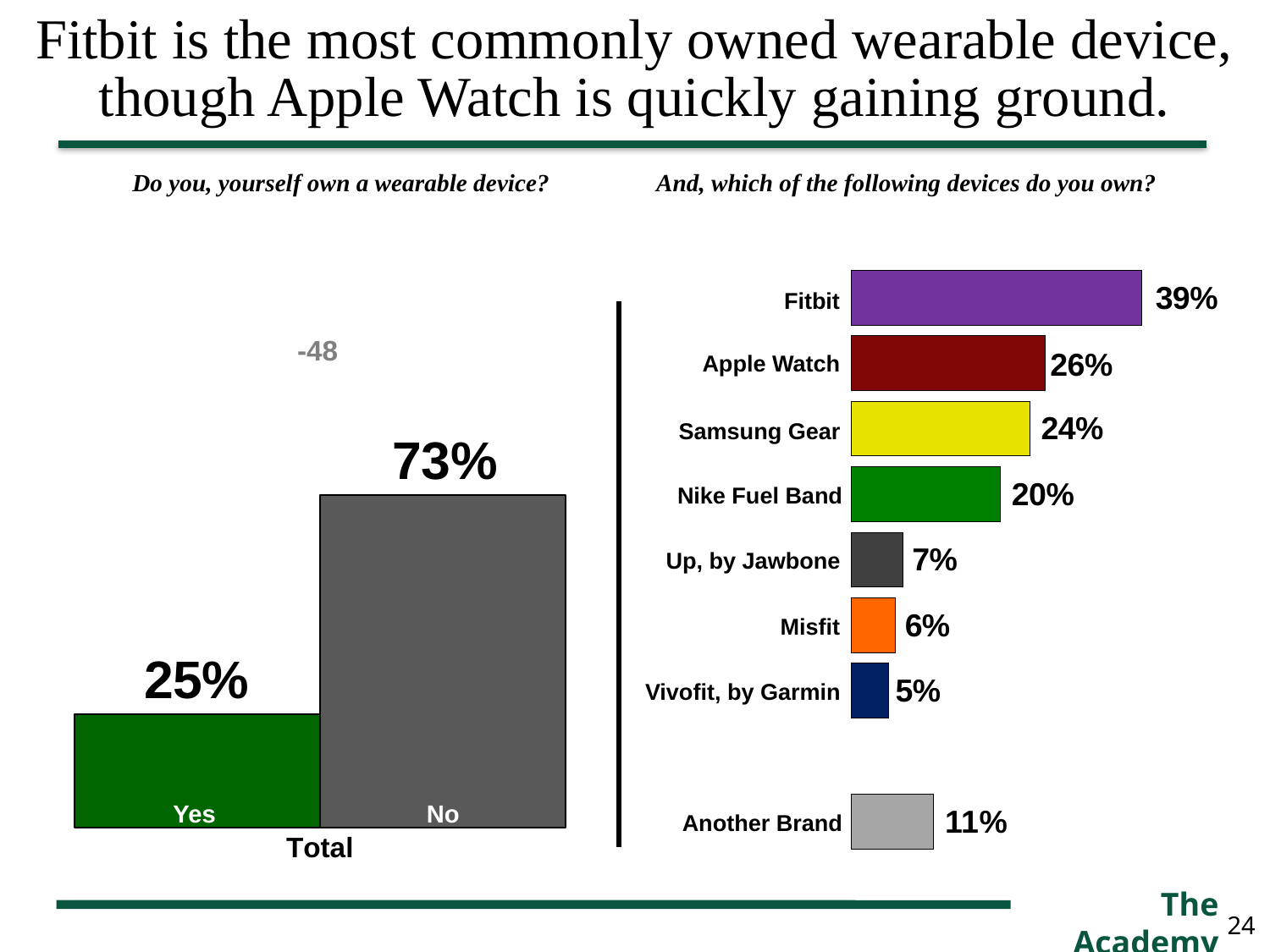
What type of chart is the right chart ('And, which of the following devices do you own?')? Bar chart How many device categories are shown in the right chart ('And, which of the following devices do you own?')? 8 In the left chart ('Do you, yourself own a wearable device?'), what percentage answered Yes? 25% In the right chart ('And, which of the following devices do you own?'), which device has the highest ownership? Fitbit In the right chart ('And, which of the following devices do you own?'), what percentage own a Samsung Gear? 24% In the right chart ('And, which of the following devices do you own?'), what is the difference between Fitbit and Apple Watch ownership? 13 percentage points In the left chart ('Do you, yourself own a wearable device?'), what is the difference between the No and Yes percentages? 48 percentage points In the right chart ('And, which of the following devices do you own?'), which is larger: Nike Fuel Band or Another Brand? Nike Fuel Band In the right chart ('And, which of the following devices do you own?'), what percentage own a Vivofit, by Garmin? 5% In the right chart ('And, which of the following devices do you own?'), which named device has the lowest ownership? Vivofit, by Garmin In the right chart ('And, which of the following devices do you own?'), what percentage own a Fitbit? 39% In the left chart ('Do you, yourself own a wearable device?'), what percentage answered No? 73%